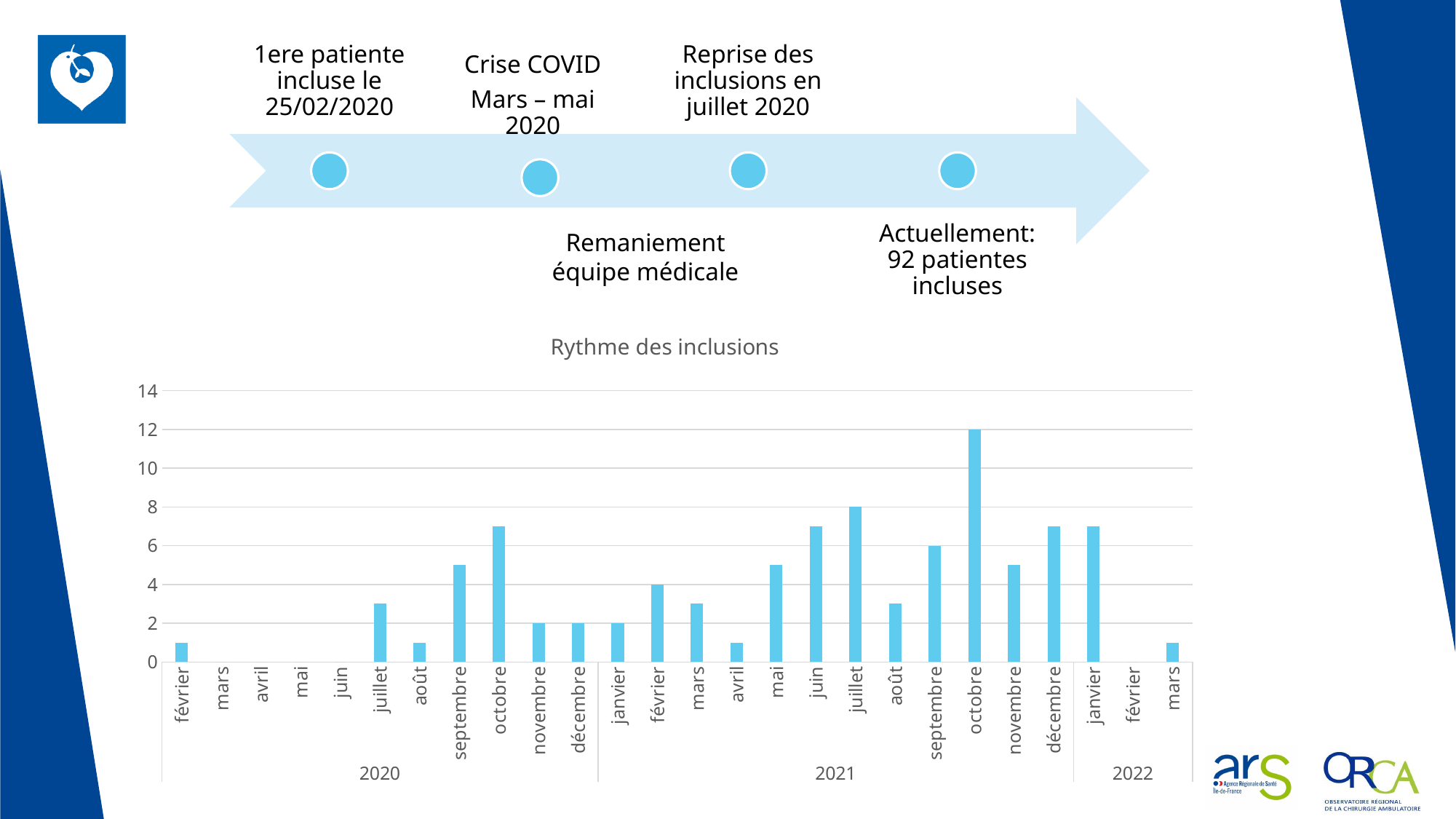
What is the value for octobre 2021? 12 What is the value for février 2021? 4 Is the value for août 2020 greater or less than 2? less What is the value for juillet 2021? 8 Is the value for juin 2021 greater or less than 6? greater What is the title of the chart? Rythme des inclusions What is the value for septembre 2021? 6 What kind of chart is shown on the slide? bar chart Which month has the highest value in the chart? octobre 2021 What is the difference between the values for octobre 2021 and juillet 2021? 4 Which is larger, the value for octobre 2021 or the value for juillet 2021? octobre 2021 How many months are listed along the x axis of the chart? 26